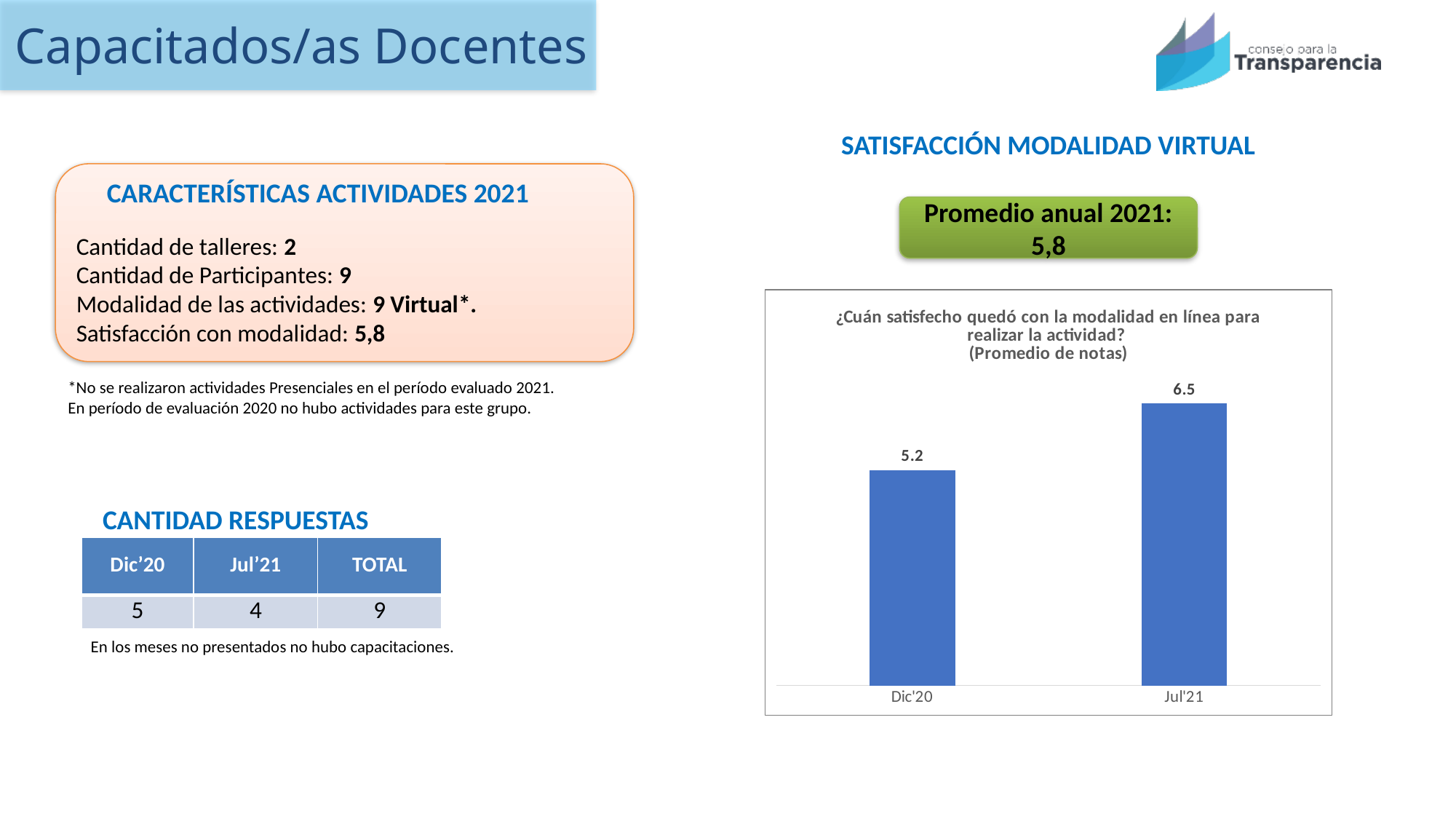
How many categories are shown on the x axis of the chart? 2 What is the value for Jul'21 in the chart? 6.5 What kind of chart is shown on the slide? Bar chart What is the difference between the Jul'21 and Dic'20 values in the chart? 1.3 Do the values in the chart rise or fall from Dic'20 to Jul'21? Rise Which is larger in the chart, the value for Dic'20 or the value for Jul'21? Jul'21 What is the title of the chart? ¿Cuán satisfecho quedó con la modalidad en línea para realizar la actividad? (Promedio de notas) Which category has the highest value in the chart? Jul'21 What colour are the bars in the chart? Blue What is the value for Dic'20 in the chart? 5.2 Which category has the lowest value in the chart? Dic'20